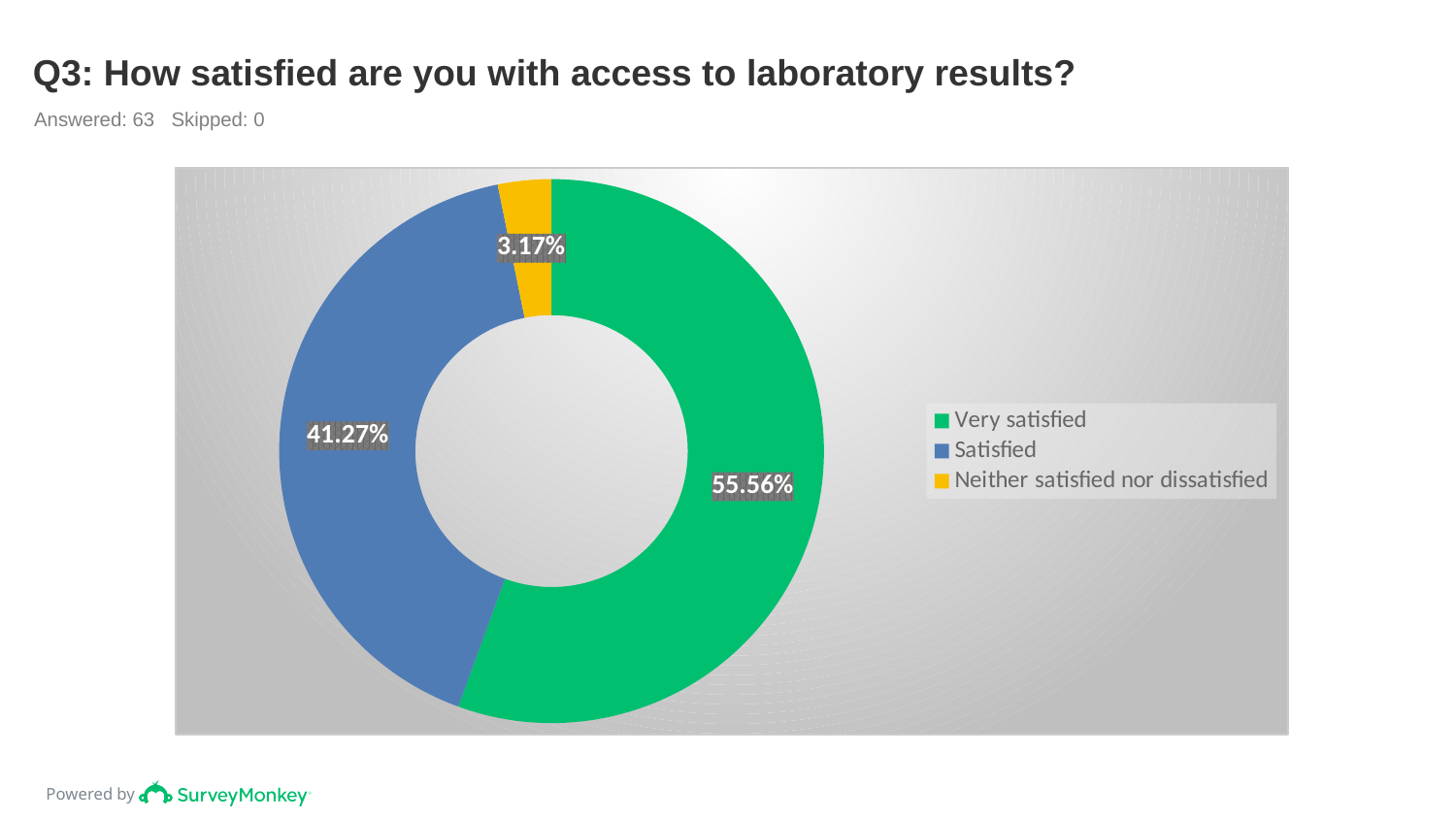
Which response category has the largest share of the chart? Very satisfied How many respondents answered this question? 63 What percentage of respondents answered "Very satisfied"? 55.56% How many response categories are shown in the chart? 3 Which response category has the smallest share of the chart? Neither satisfied nor dissatisfied What kind of chart is shown on the slide? Pie chart (doughnut) What colour represents "Satisfied" in the chart? Blue What percentage of respondents answered "Satisfied"? 41.27% What percentage of respondents answered "Neither satisfied nor dissatisfied"? 3.17% Which is larger, the share for "Satisfied" or the share for "Neither satisfied nor dissatisfied"? Satisfied What is the difference in percentage points between "Very satisfied" and "Satisfied"? 14.29